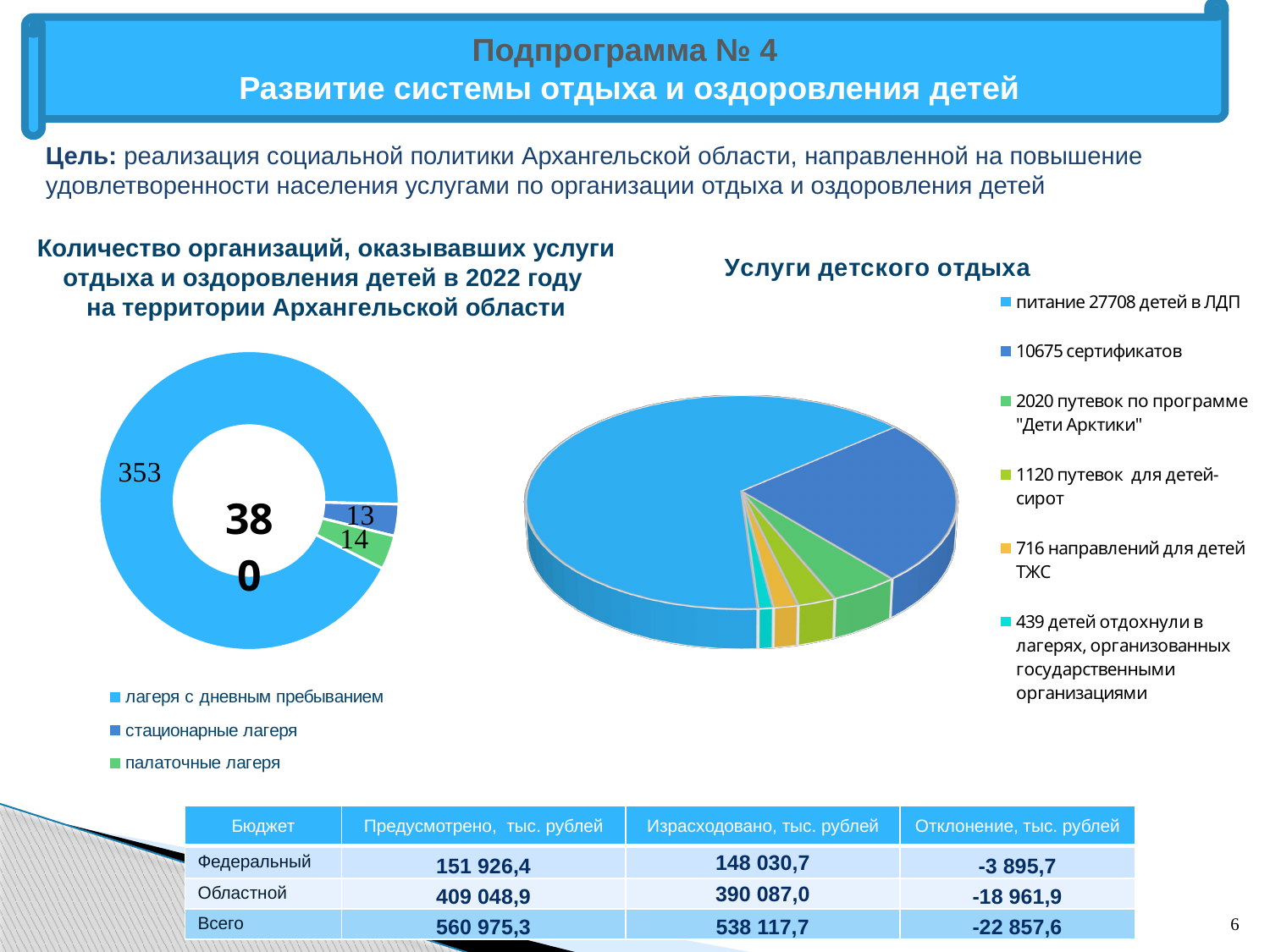
How many entries does the legend of the chart 'Услуги детского отдыха' list? 6 How many categories does the legend of the doughnut chart on the left list? 3 In the chart 'Услуги детского отдыха', which legend entry corresponds to the largest slice? питание 27708 детей в ЛДП In the doughnut chart on the left, what is the value for лагеря с дневным пребыванием? 353 What kind of chart is the chart titled 'Услуги детского отдыха'? pie chart In the chart 'Услуги детского отдыха', how many сертификатов are shown in the legend? 10675 In the doughnut chart on the left, which category has the highest value? лагеря с дневным пребыванием In the doughnut chart on the left, what is the difference between лагеря с дневным пребыванием and палаточные лагеря? 339 In the doughnut chart on the left, what is the value for стационарные лагеря? 13 In the doughnut chart on the left, what is the value for палаточные лагеря? 14 In the doughnut chart on the left, what is the total number shown in the centre of the chart? 380 In the doughnut chart on the left, which category has the lowest value? стационарные лагеря